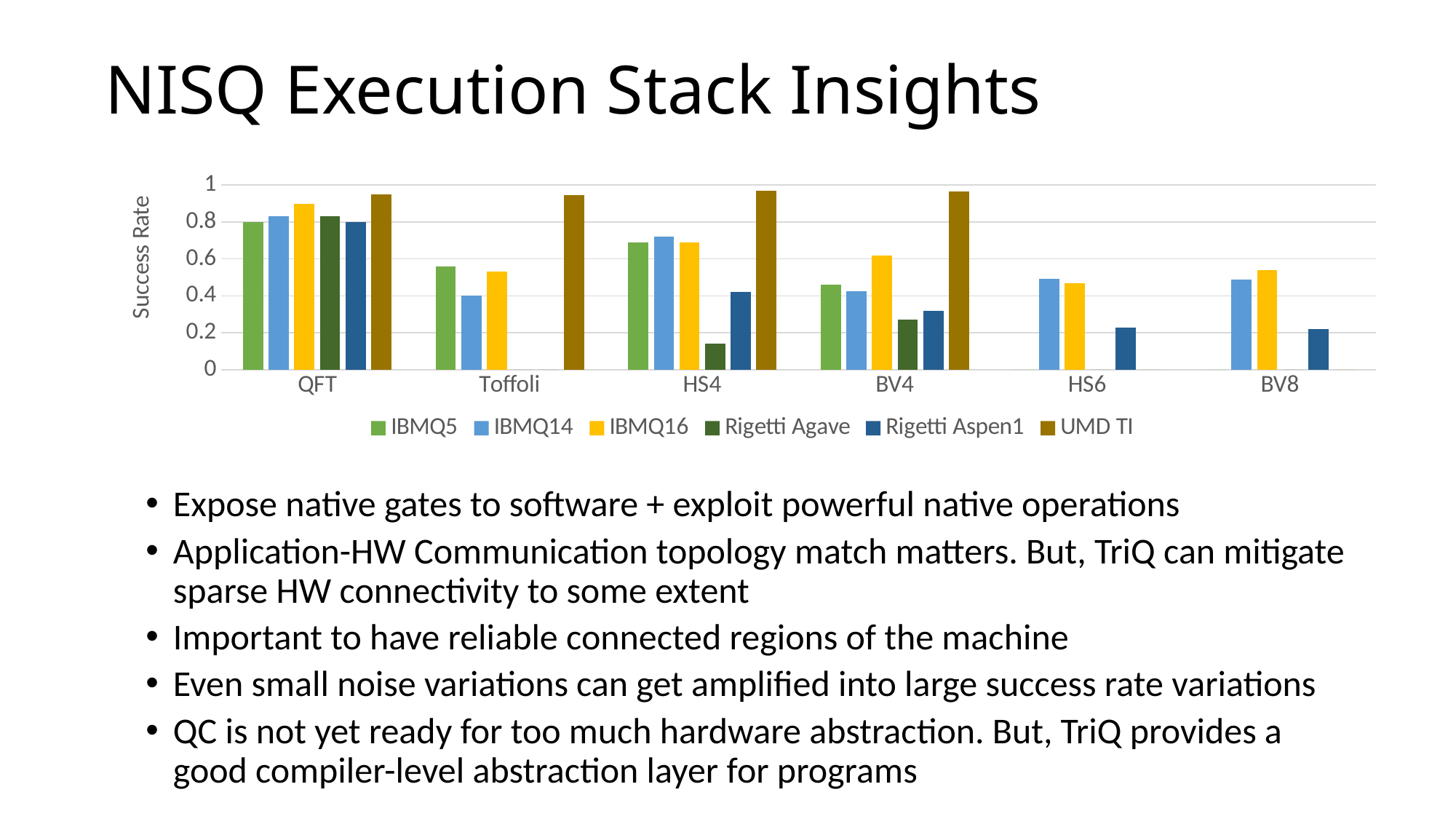
What is the label on the y axis of the chart? Success Rate Is the success rate for Rigetti Aspen1 on HS6 greater or less than 0.4? less How many series does the legend list? 6 For Toffoli, which has the higher success rate: IBMQ5 or IBMQ14? IBMQ5 Which series has the lowest success rate for HS4? Rigetti Agave How many benchmark categories are shown on the x axis? 6 What kind of chart is shown on the slide? bar chart Which series has the highest success rate for QFT? UMD TI For BV4, which has the higher success rate: IBMQ16 or IBMQ14? IBMQ16 Which series has the highest success rate for BV4? UMD TI Is the success rate for UMD TI on Toffoli greater or less than 0.8? greater Is the success rate for Rigetti Agave on HS4 greater or less than 0.2? less